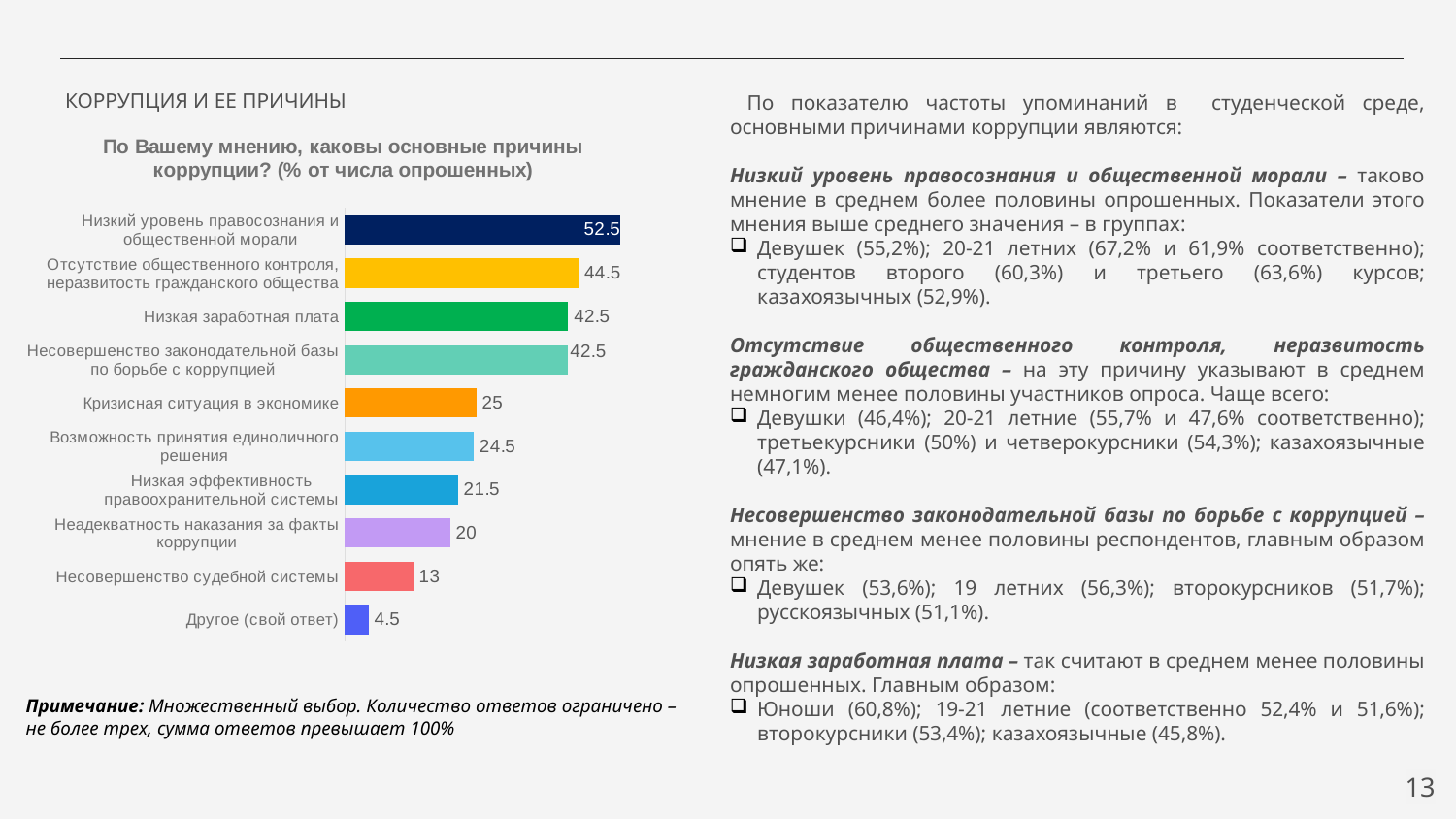
What is the value for "Несовершенство судебной системы"? 13 What is the value for "Другое (свой ответ)"? 4.5 Which category has the lowest value? Другое (свой ответ) What is the value for "Кризисная ситуация в экономике"? 25 What type of chart is shown on the slide? Bar chart What is the value for "Низкий уровень правосознания и общественной морали"? 52.5 Which category has the highest value? Низкий уровень правосознания и общественной морали What is the difference between the values for "Низкая заработная плата" and "Несовершенство судебной системы"? 29.5 What is the title of the chart? По Вашему мнению, каковы основные причины коррупции? (% от числа опрошенных) How many categories are shown in the chart? 10 What is the difference between the values for "Низкий уровень правосознания и общественной морали" and "Отсутствие общественного контроля, неразвитость гражданского общества"? 8 Which is larger: the value for "Неадекватность наказания за факты коррупции" or for "Несовершенство судебной системы"? Неадекватность наказания за факты коррупции